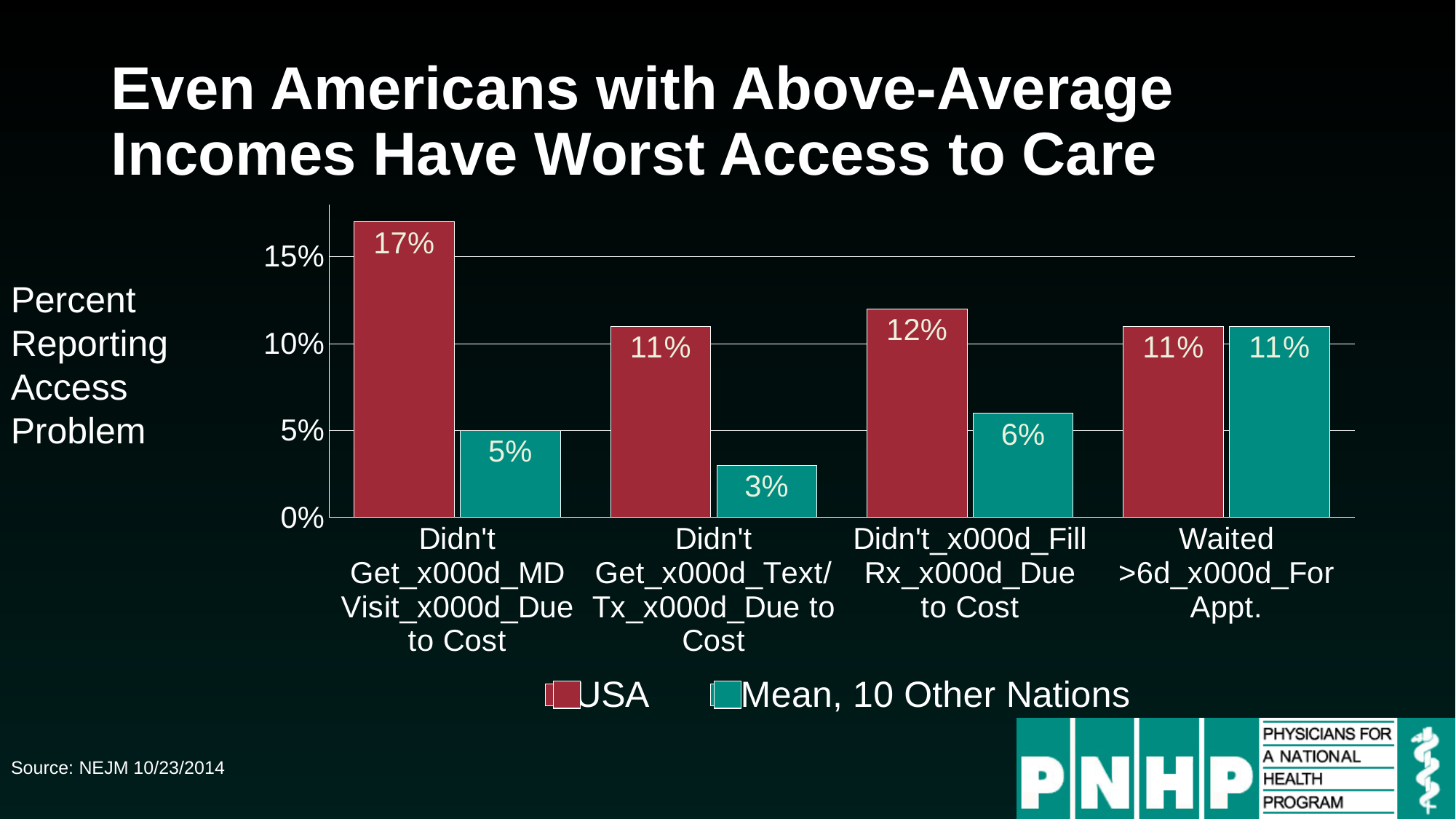
Which category has the lowest value for Mean, 10 Other Nations? Didn't Get Text/Tx Due to Cost What is the USA value for "Didn't Fill Rx Due to Cost"? 12% What is the source cited at the bottom of the slide? NEJM 10/23/2014 How many categories are shown on the x axis? 4 What is the difference between the USA value and the Mean, 10 Other Nations value for "Didn't Get MD Visit Due to Cost"? 12% For "Didn't Fill Rx Due to Cost", which is larger: the USA value or the Mean, 10 Other Nations value? USA Which category has the highest USA value? Didn't Get MD Visit Due to Cost How many series does the legend list? 2 What is the USA value for "Didn't Get MD Visit Due to Cost"? 17% What kind of chart is shown on the slide? Bar chart What is the value for Mean, 10 Other Nations for "Didn't Get Text/Tx Due to Cost"? 3% What is the value for Mean, 10 Other Nations for "Waited >6d For Appt."? 11%